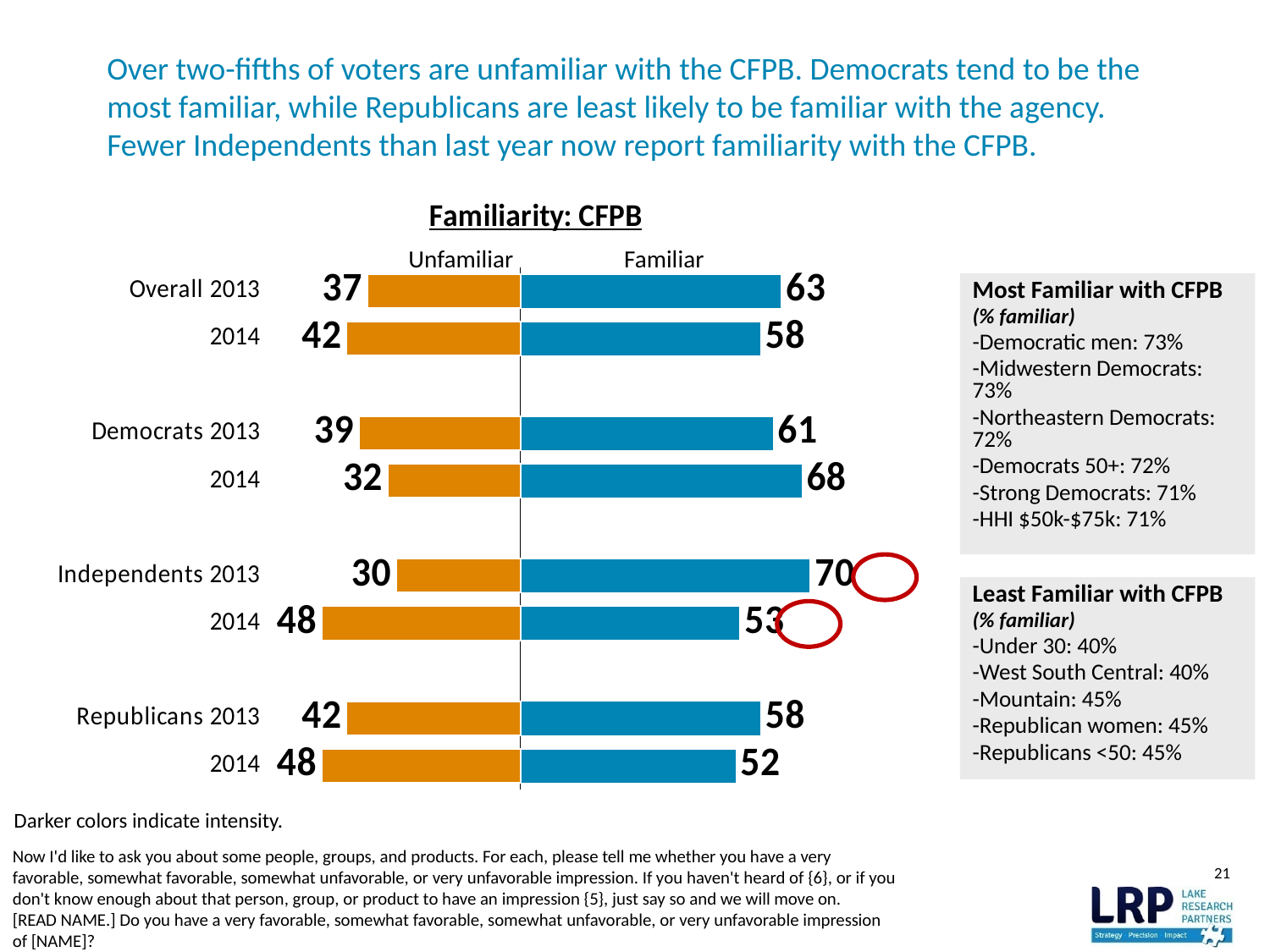
What is the Unfamiliar value for Democrats in 2014? 32 How many bars (group-year rows) are plotted in the chart? 8 What is the difference between the Familiar values for Democrats 2014 and Republicans 2014? 16 What is the Familiar value for Independents in 2013? 70 What is the Familiar value for Republicans in 2014? 52 Which is larger, the Familiar value for Democrats 2013 or for Overall 2013? Overall 2013 What type of chart is shown? Bar chart What is the Unfamiliar value for Overall in 2013? 37 Which group and year has the lowest Familiar value? Republicans 2014 Which group and year has the highest Familiar value? Independents 2013 By how much did the Familiar value for Independents fall from 2013 to 2014? 17 What is the title of the chart? Familiarity: CFPB